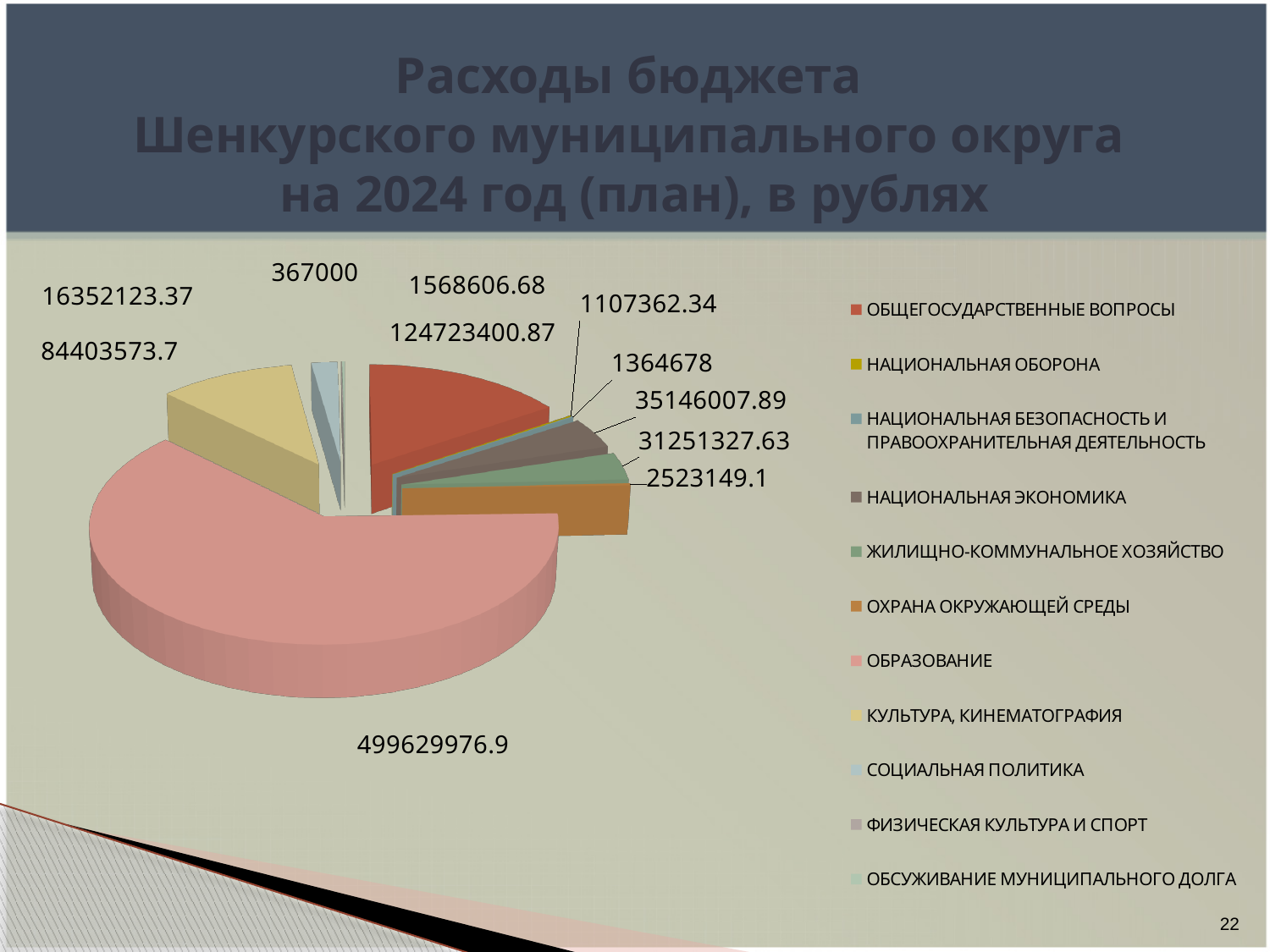
What is the value shown for ОБРАЗОВАНИЕ? 499629976.9 What is the smallest value labelled on the pie chart? 367000 What colour is the slice for ОБРАЗОВАНИЕ in the pie chart? pink What year does the chart title say the budget expenditure plan is for? 2024 What is the value shown for НАЦИОНАЛЬНАЯ ЭКОНОМИКА? 35146007.89 What is the difference between the values for ОБРАЗОВАНИЕ and ОБЩЕГОСУДАРСТВЕННЫЕ ВОПРОСЫ? 374906576.03 Which is larger: ОБРАЗОВАНИЕ or ОБЩЕГОСУДАРСТВЕННЫЕ ВОПРОСЫ? ОБРАЗОВАНИЕ What kind of chart is shown on the slide? pie chart How many categories does the legend of the pie chart list? 11 What is the value shown for ОБЩЕГОСУДАРСТВЕННЫЕ ВОПРОСЫ? 124723400.87 Which category has the largest slice of the pie chart? ОБРАЗОВАНИЕ What is the value shown for КУЛЬТУРА, КИНЕМАТОГРАФИЯ? 84403573.7